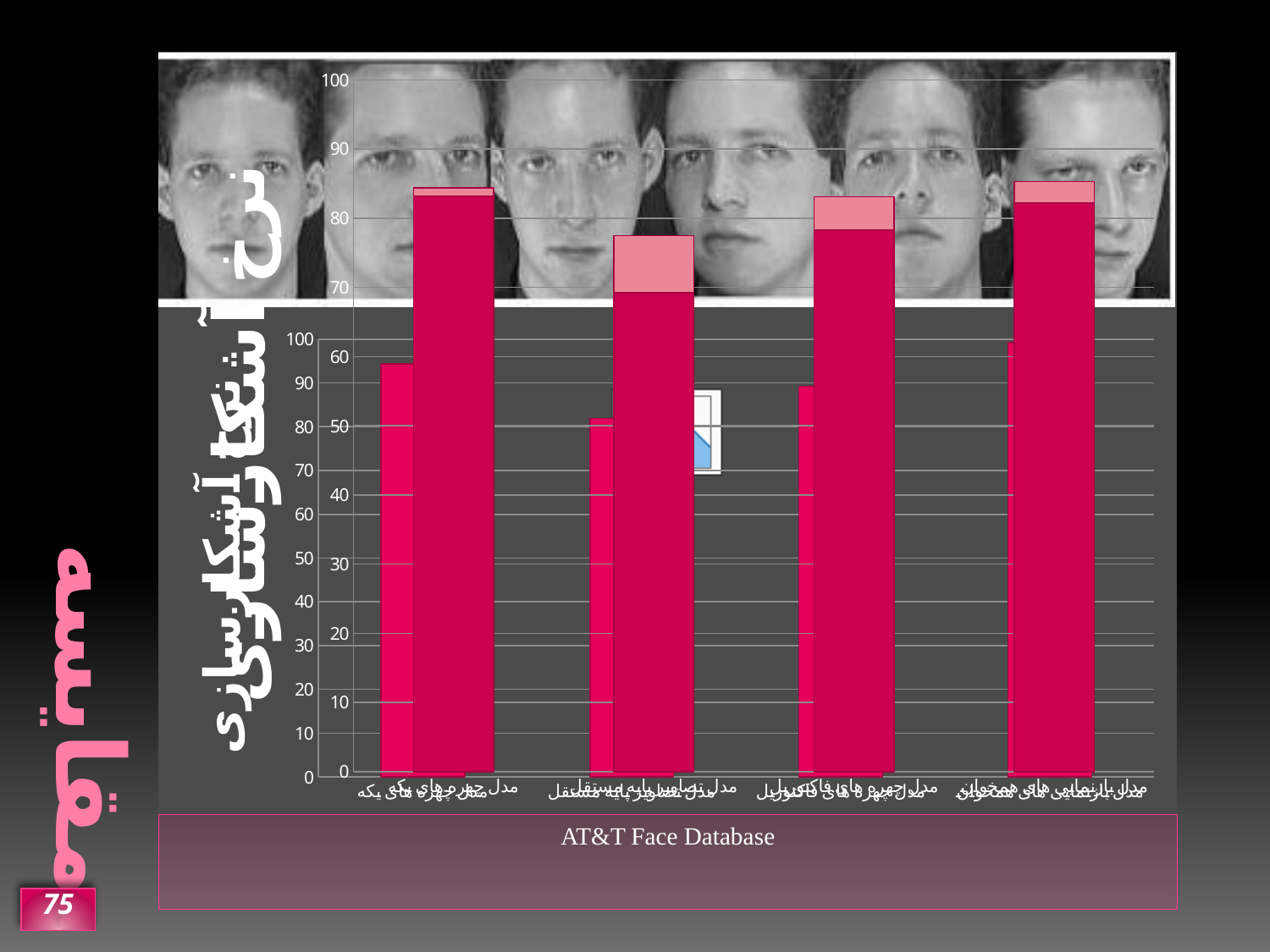
In the front chart (whose 100 tick sits below the photos), is the value of the second bar from the left greater or less than 90? less In the front chart (whose 100 tick sits below the photos), is the first bar from the left taller or shorter than the second bar? taller What database name is written in the caption box below the charts? AT&T Face Database In the back chart (whose 100 tick sits at the top over the photos), which bar is the lowest: the first, second, third or fourth from the left? second In the back chart (whose 100 tick sits at the top over the photos), how many bars are plotted? 4 In the back chart (whose 100 tick sits at the top over the photos), is the value of the second bar from the left greater or less than 80? less In the front chart (whose 100 tick sits below the photos), which bar is the highest: the first, second, third or fourth from the left? fourth In the back chart (whose 100 tick sits at the top over the photos), is the value of the fourth bar from the left greater or less than 80? greater What kind of chart is shown on the slide? bar chart In the front chart (whose 100 tick sits below the photos), which bar is the lowest: the first, second, third or fourth from the left? second In the front chart (whose 100 tick sits below the photos), how many bars are plotted? 4